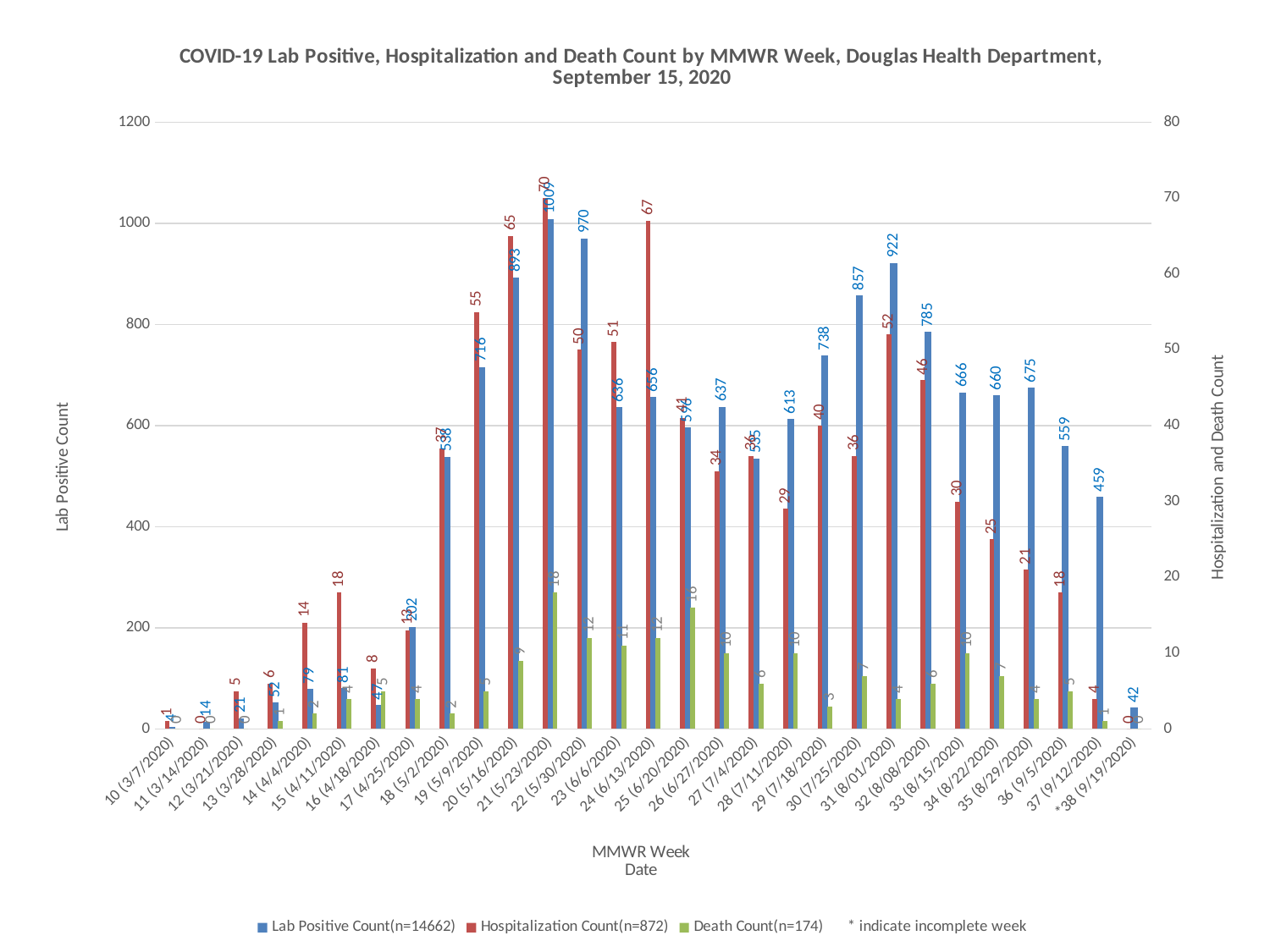
What is the Lab Positive Count for MMWR week 31 (8/01/2020)? 922 What is the highest Hospitalization Count shown on the chart? 70 What is the difference between the Lab Positive Count for week 21 (5/23/2020) and week 22 (5/30/2020)? 39 What is the Lab Positive Count for MMWR week 37 (9/12/2020)? 459 How many series does the legend list? 3 Which is larger, the Lab Positive Count for week 30 (7/25/2020) or for week 32 (8/08/2020)? week 30 (7/25/2020) What is the Hospitalization Count for MMWR week 24 (6/13/2020)? 67 Which MMWR week has the highest Lab Positive Count? 21 (5/23/2020) According to the legend, what is the total n for the Hospitalization Count series? 872 What is the Death Count for MMWR week 25 (6/20/2020)? 16 How many MMWR weeks are shown on the x axis? 29 What kind of chart is shown on the slide? bar chart